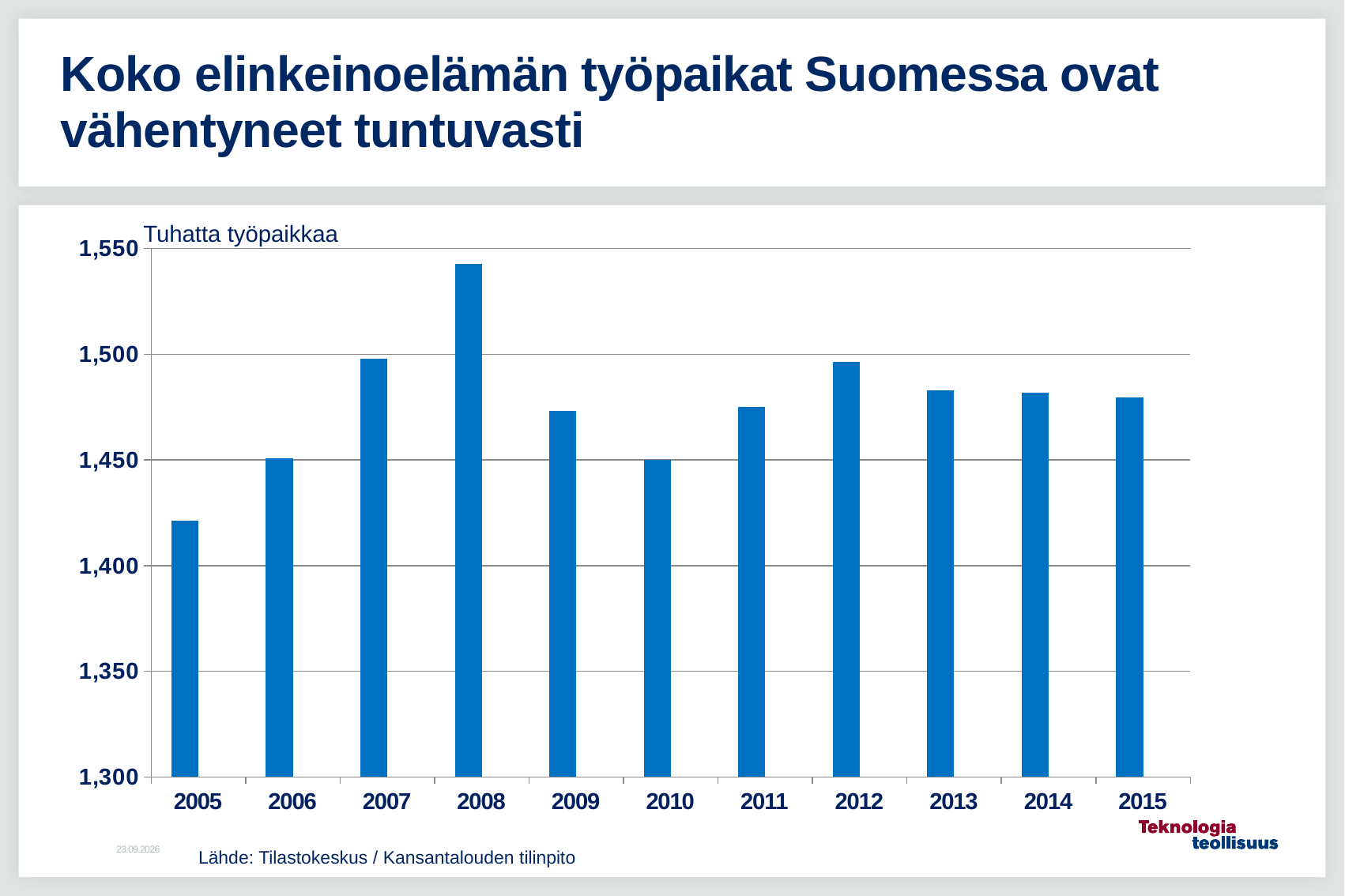
What kind of chart is shown on the slide? Bar chart Which year has the larger value, 2005 or 2006? 2006 Is the value for 2005 greater or less than 1,450? less Which year has the highest number of jobs in the chart? 2008 Is the value for 2008 greater or less than 1,500? greater Which year has the larger value, 2008 or 2009? 2008 Is the value for 2015 greater or less than 1,500? less Which year has the lowest number of jobs in the chart? 2005 Do the values rise or fall from 2012 to 2015? fall How many years are shown on the x axis of the chart? 11 What unit label is shown above the vertical axis of the chart? Tuhatta työpaikkaa